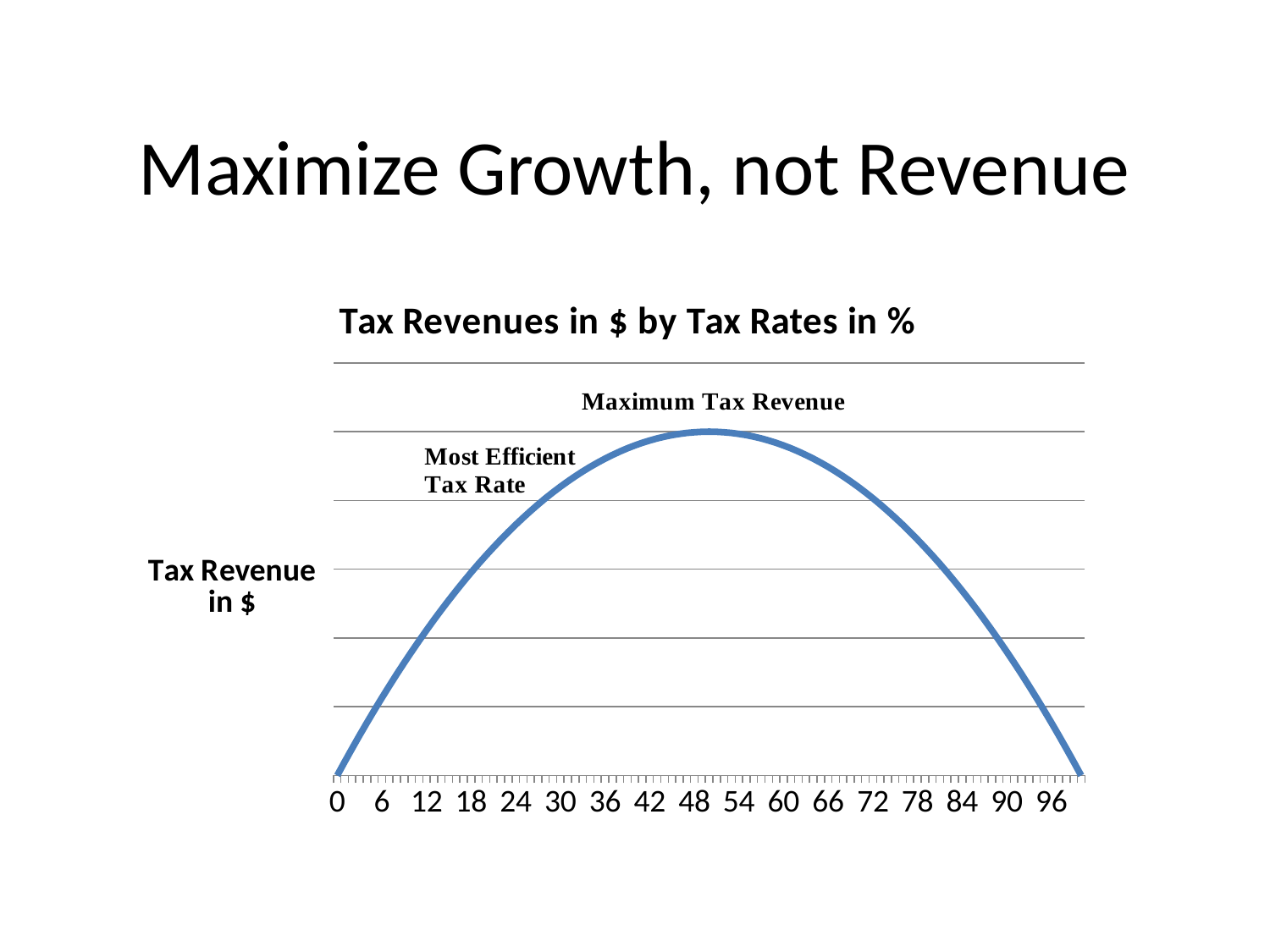
What is the step between consecutive tax-rate labels on the x axis? 6 Is tax revenue higher at a tax rate of 12 or at a tax rate of 48? 48 What is the highest tax-rate label shown on the x axis? 96 What label is placed at the peak of the curve? Maximum Tax Revenue How many tax-rate labels are shown along the x axis? 17 Is tax revenue higher at a tax rate of 24 or at a tax rate of 96? 24 Does tax revenue rise or fall as the tax rate increases from 60 to 96? fall What is the title of the chart? Tax Revenues in $ by Tax Rates in % Does tax revenue rise or fall as the tax rate increases from 0 to 30? rise What kind of chart is shown on the slide? line chart Is tax revenue higher at a tax rate of 54 or at a tax rate of 96? 54